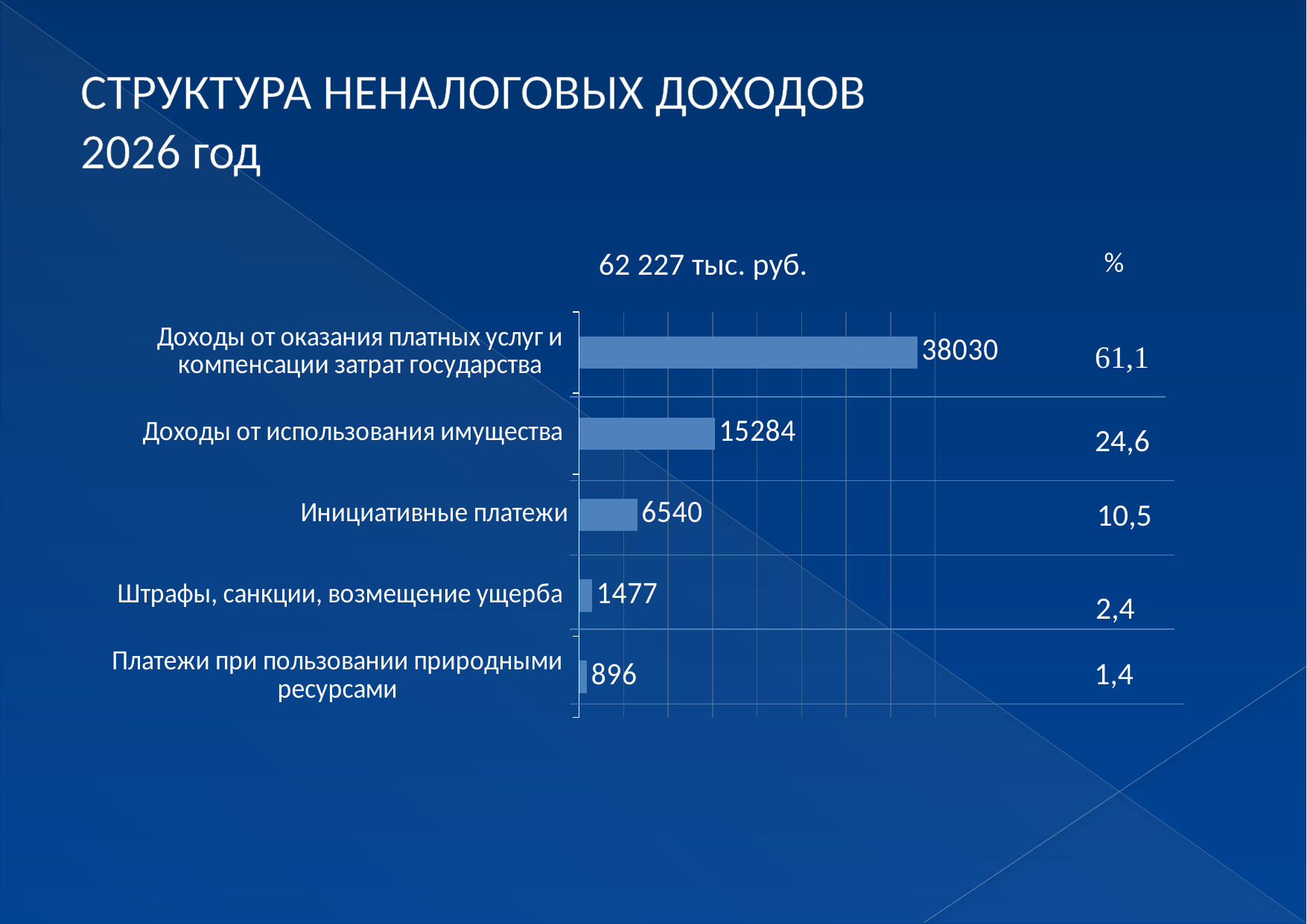
What is the title of the slide? СТРУКТУРА НЕНАЛОГОВЫХ ДОХОДОВ 2026 год What is the difference between the values for «Доходы от использования имущества» and «Инициативные платежи»? 8744 What kind of chart is shown on the slide? Bar chart How many categories are shown in the chart? 5 What total amount is shown above the chart? 62 227 тыс. руб. What percentage share is shown for «Доходы от использования имущества»? 24,6 Which category has the lowest value? Платежи при пользовании природными ресурсами Which is larger: the value for «Штрафы, санкции, возмещение ущерба» or «Платежи при пользовании природными ресурсами»? Штрафы, санкции, возмещение ущерба What is the value for «Платежи при пользовании природными ресурсами»? 896 What is the value for «Инициативные платежи»? 6540 Which category has the highest value? Доходы от оказания платных услуг и компенсации затрат государства What is the value for «Доходы от оказания платных услуг и компенсации затрат государства»? 38030